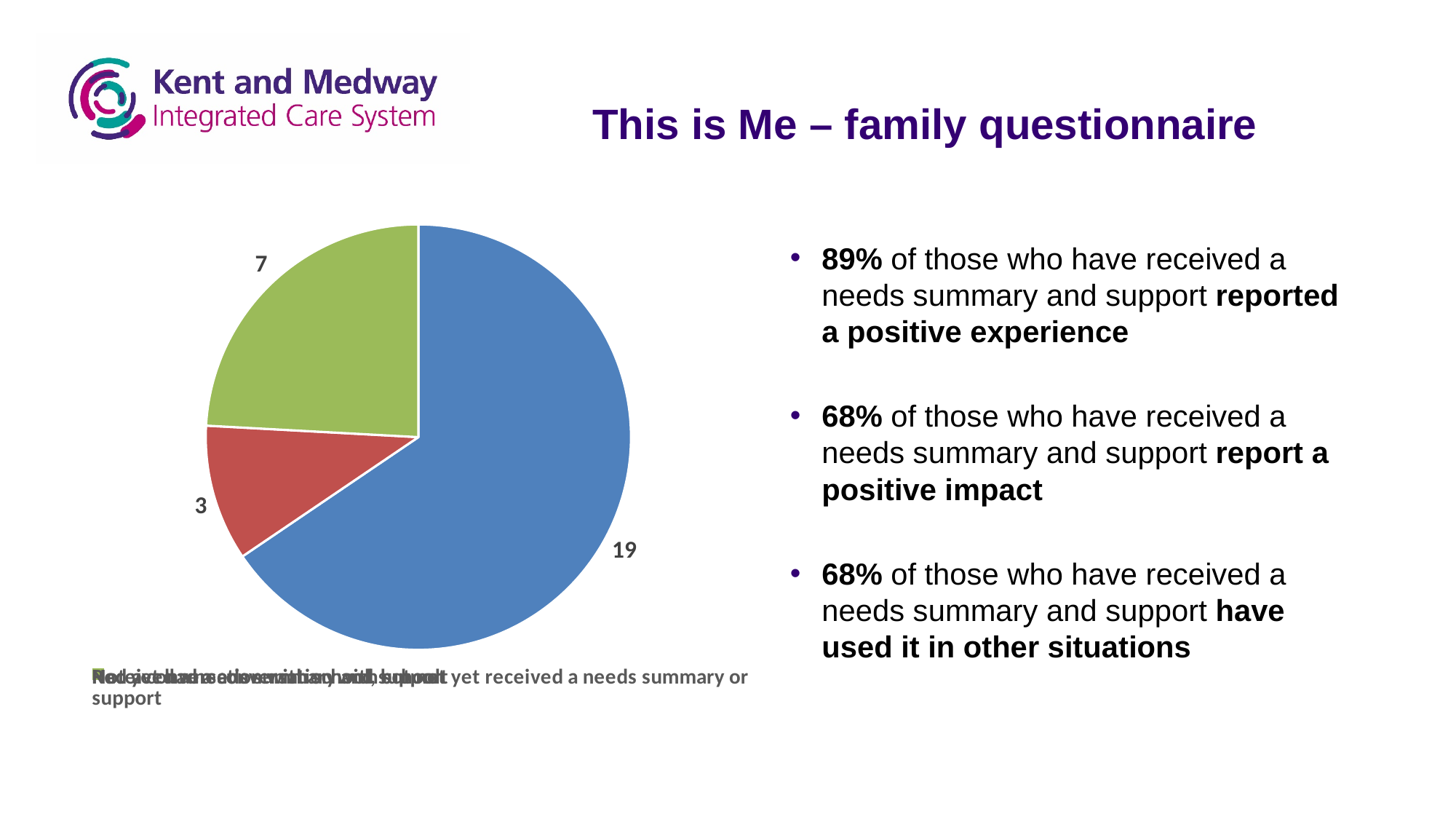
What value is labelled on the blue slice of the pie chart? 19 What fraction of the pie chart's total does the blue slice represent? 19/29 How many slices does the pie chart have? 3 What value is labelled on the red slice of the pie chart? 3 Which colour slice of the pie chart is the smallest? red What is the total of all the values shown on the pie chart? 29 What value is labelled on the green slice of the pie chart? 7 What type of chart is shown on the slide? pie chart What is the difference between the blue slice value and the green slice value in the pie chart? 12 Which colour slice of the pie chart is the largest? blue Which slice has the larger value in the pie chart, the green slice or the red slice? green What is the difference between the green slice value and the red slice value in the pie chart? 4